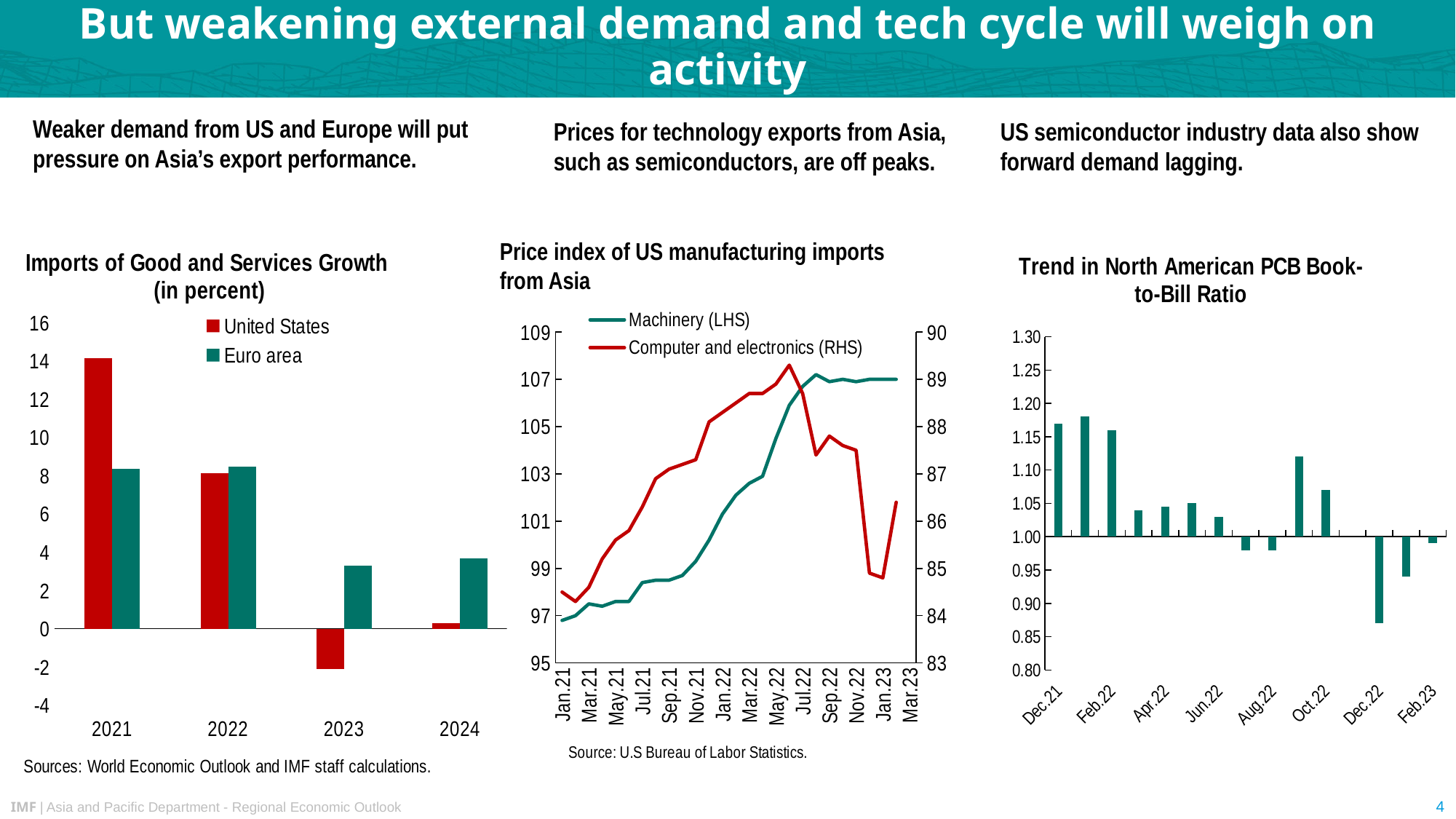
In the 'Imports of Good and Services Growth' chart, how many years are shown on the x axis? 4 In the 'Imports of Good and Services Growth' chart, which year has the lowest value for United States? 2023 In the 'Trend in North American PCB Book-to-Bill Ratio' chart, is the value for Dec.22 greater or less than 0.90? less In the 'Trend in North American PCB Book-to-Bill Ratio' chart, which month has the lowest value? Dec.22 In the 'Imports of Good and Services Growth' chart, which series has the larger value in 2023, United States or Euro area? Euro area In the 'Price index of US manufacturing imports from Asia' chart, what kind of chart is it? line chart In the 'Imports of Good and Services Growth' chart, how many series does the legend list? 2 In the 'Imports of Good and Services Growth' chart, what kind of chart is it? bar chart In the 'Price index of US manufacturing imports from Asia' chart, does the Machinery (LHS) line generally rise or fall from Jan.21 to Jan.23? rise In the 'Imports of Good and Services Growth' chart, is the United States value for 2021 greater or less than 12? greater In the 'Imports of Good and Services Growth' chart, which year has the highest value for United States? 2021 In the 'Price index of US manufacturing imports from Asia' chart, how many series does the legend list? 2